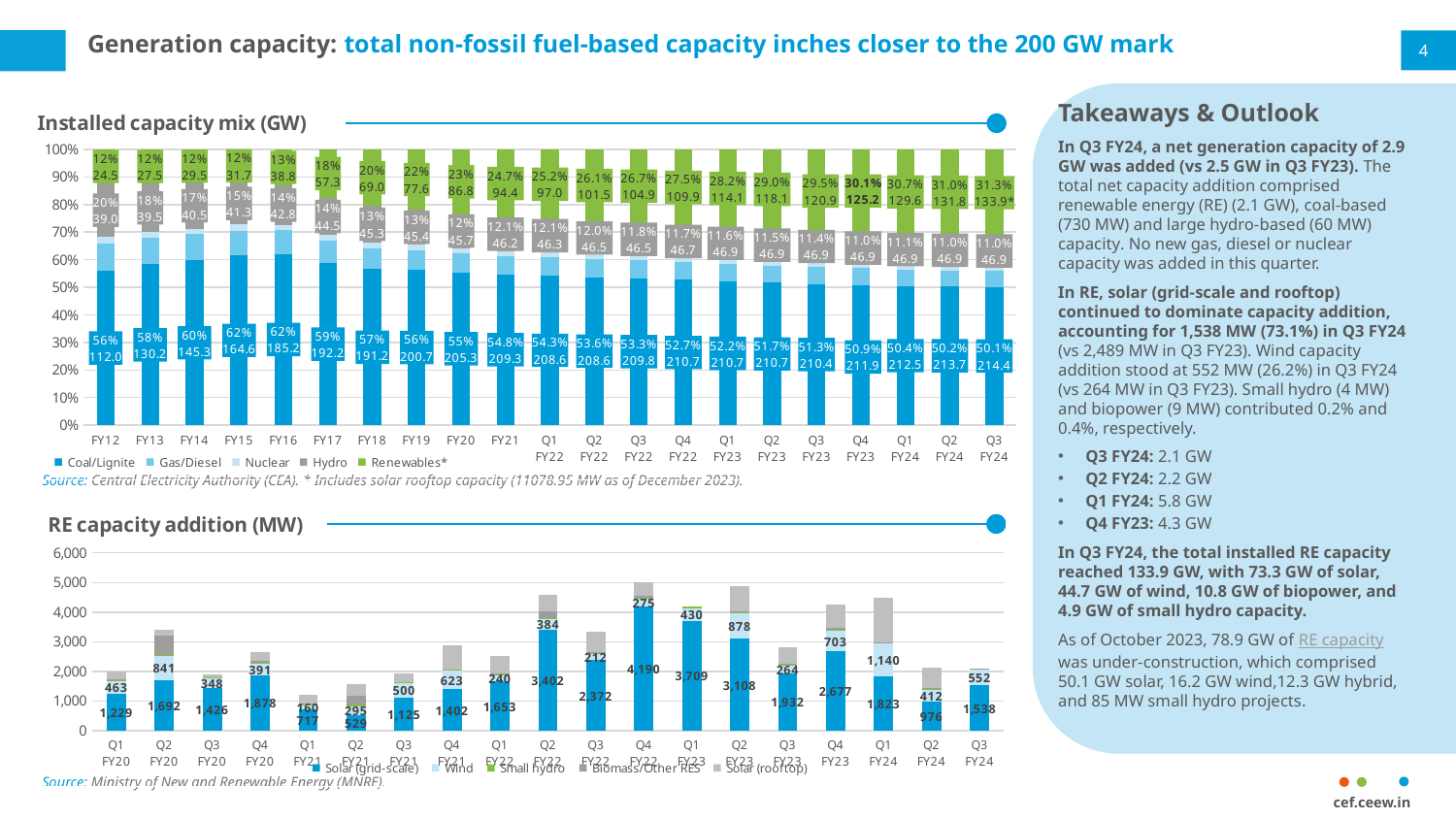
In the 'RE capacity addition (MW)' chart, which quarter has the highest Solar (grid-scale) value? Q4 FY22 What kind of chart is the 'Installed capacity mix (GW)' chart? Stacked bar chart In the 'RE capacity addition (MW)' chart, what is the difference between the Solar (grid-scale) values for Q3 FY24 and Q2 FY24? 562 In the 'Installed capacity mix (GW)' chart, which period has the highest Renewables share? Q3 FY24 How many series does the legend of the 'Installed capacity mix (GW)' chart list? 5 In the 'RE capacity addition (MW)' chart, what is the Solar (grid-scale) value for Q4 FY22? 4,190 In the 'RE capacity addition (MW)' chart, which is larger: the Wind value for Q2 FY23 or for Q4 FY23? Q2 FY23 In the 'Installed capacity mix (GW)' chart, do the Renewables values rise or fall from FY12 to Q3 FY24? Rise How many series does the legend of the 'RE capacity addition (MW)' chart list? 5 In the 'RE capacity addition (MW)' chart, what is the Wind value for Q1 FY24? 1,140 In the 'Installed capacity mix (GW)' chart, what is the Renewables value for FY12? 24.5 In the 'Installed capacity mix (GW)' chart, what is the Coal/Lignite value for Q3 FY24? 214.4